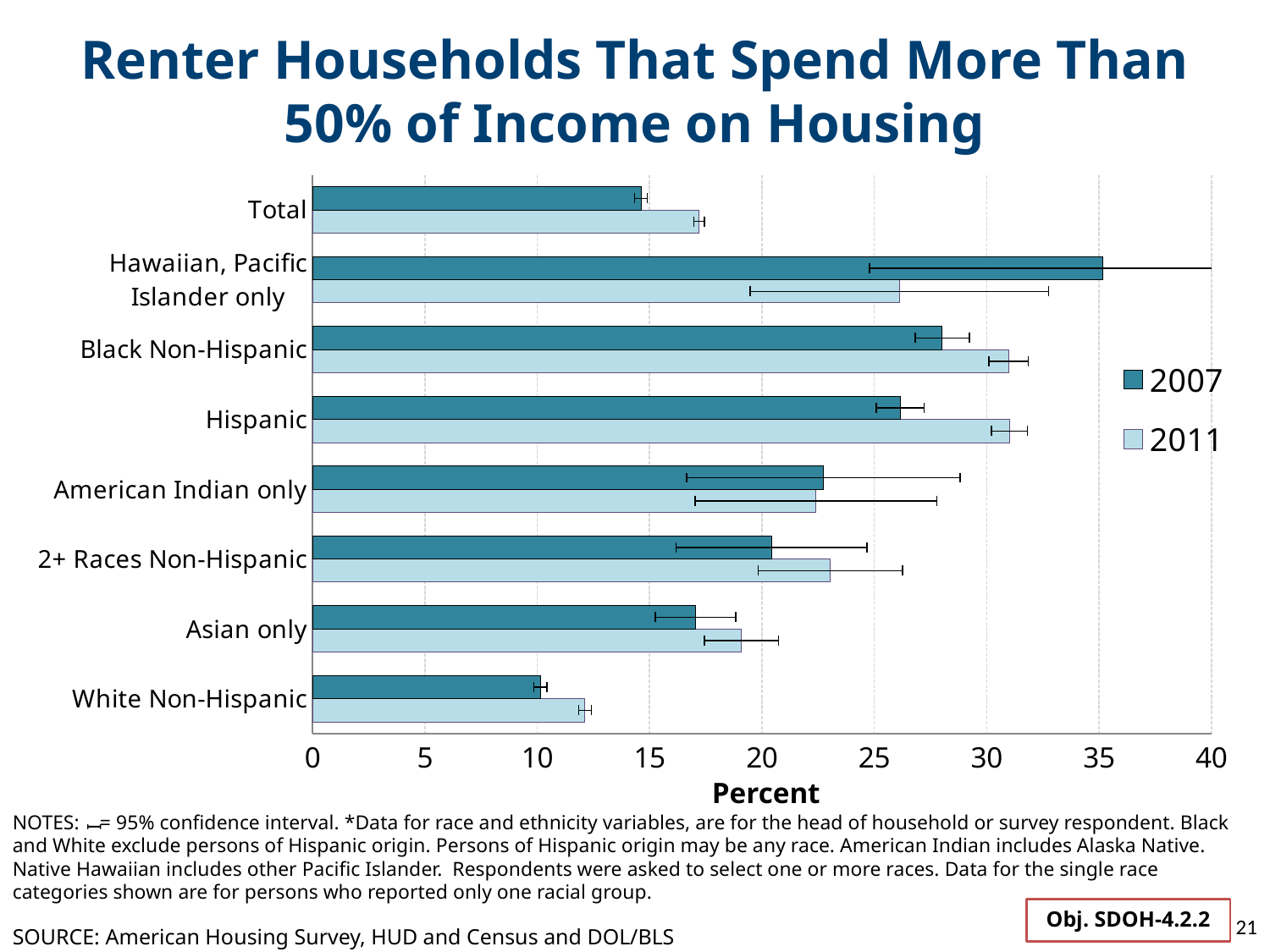
What is the label of the horizontal axis? Percent How many series does the legend list? 2 Is the 2007 value for Hawaiian, Pacific Islander only greater or less than 30? greater Is the 2011 value for Black Non-Hispanic greater or less than 25? greater Which category has the highest 2007 value? Hawaiian, Pacific Islander only Which category has the lowest 2007 value? White Non-Hispanic Which category has the lowest 2011 value? White Non-Hispanic How many categories are shown on the vertical axis of the chart? 8 What kind of chart is shown on the slide? bar chart Is the 2011 value for Total greater or less than 20? less For Hawaiian, Pacific Islander only, which year has the larger value, 2007 or 2011? 2007